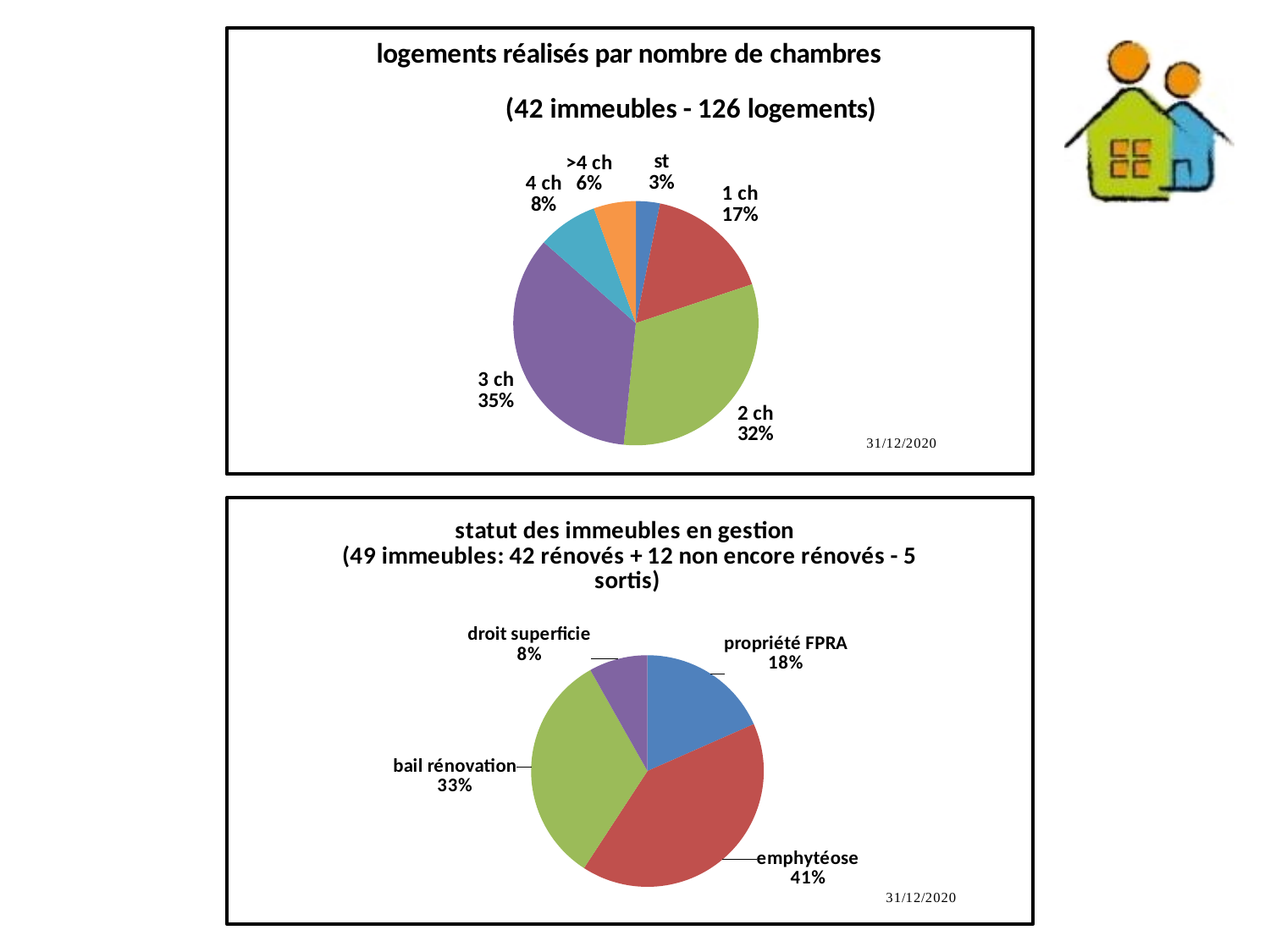
In the 'statut des immeubles en gestion' chart, which is larger: bail rénovation or propriété FPRA? bail rénovation In the 'logements réalisés par nombre de chambres' chart, how many categories are shown? 6 In the 'statut des immeubles en gestion' chart, what share is emphytéose? 41% In the 'statut des immeubles en gestion' chart, how many categories are shown? 4 What date is shown in the bottom right corner of the 'logements réalisés par nombre de chambres' chart? 31/12/2020 In the 'logements réalisés par nombre de chambres' chart, what is the difference in percentage points between 2 ch and 4 ch? 24 In the 'statut des immeubles en gestion' chart, what share is droit superficie? 8% In the 'logements réalisés par nombre de chambres' chart, which category has the largest share? 3 ch In the 'logements réalisés par nombre de chambres' chart, which category has the smallest share? st What type of chart is the 'statut des immeubles en gestion' chart? Pie chart In the 'logements réalisés par nombre de chambres' chart, what share do 1 ch dwellings represent? 17% In the 'logements réalisés par nombre de chambres' chart, what share do 3 ch dwellings represent? 35%